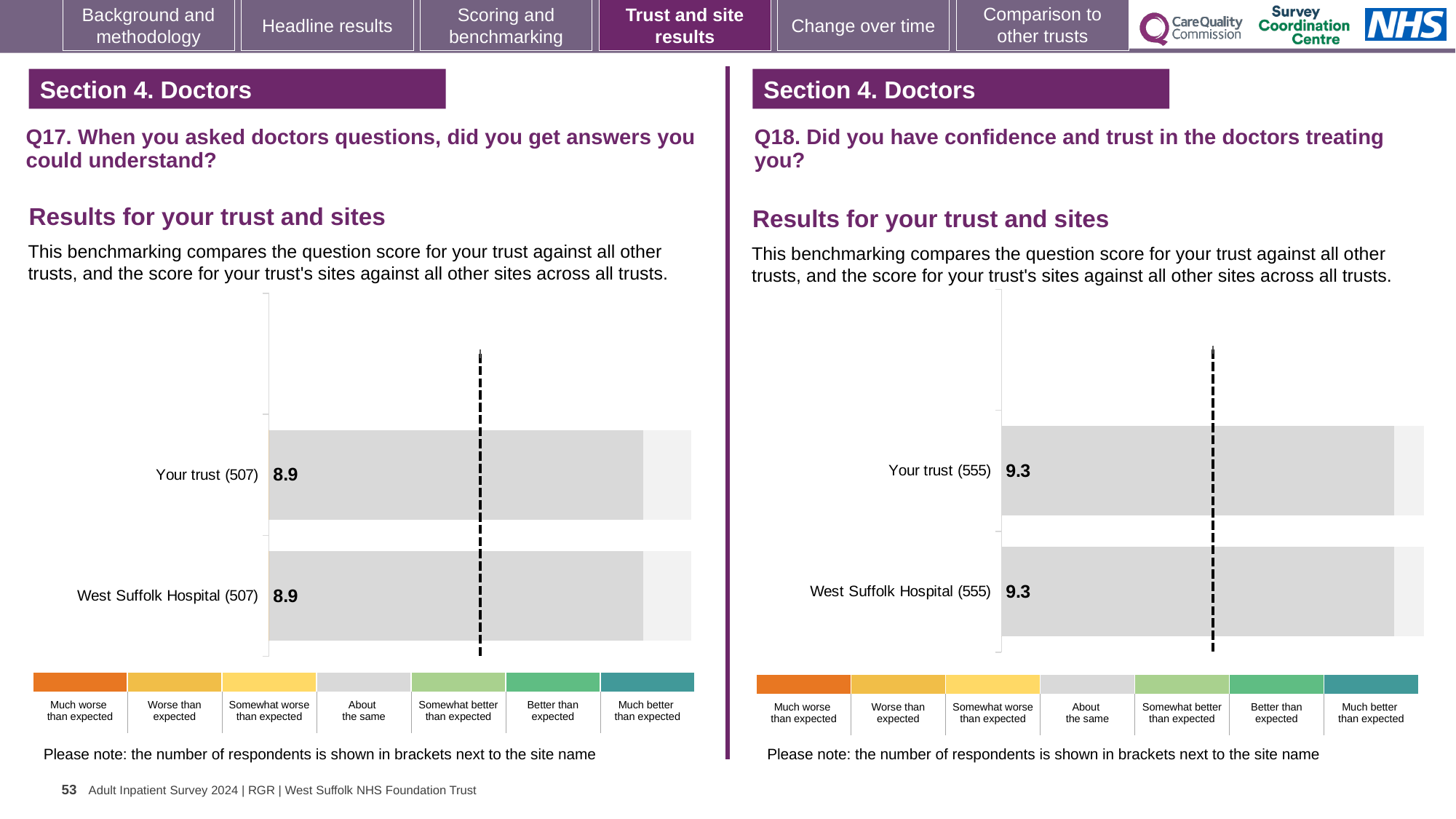
On the Q17 chart (left), how many respondents are shown in brackets next to Your trust? 507 On the Q18 chart (right), what is the score for West Suffolk Hospital? 9.3 On the Q17 chart (left), what is the difference between the Your trust score and the West Suffolk Hospital score? 0 Is the Your trust score on the Q18 chart (right) larger or smaller than the Your trust score on the Q17 chart (left)? Larger On the Q17 chart (left), what is the score for West Suffolk Hospital? 8.9 On the Q17 chart (left), what is the score for Your trust? 8.9 What kind of chart is used on the Q17 chart (left)? Bar chart On the Q18 chart (right), how many respondents are shown in brackets next to West Suffolk Hospital? 555 On the Q18 chart (right), what is the score for Your trust? 9.3 On the Q18 chart (right), what is the difference between the Your trust score and the West Suffolk Hospital score? 0 How many bars are plotted on the Q17 chart (left)? 2 How many bars are plotted on the Q18 chart (right)? 2